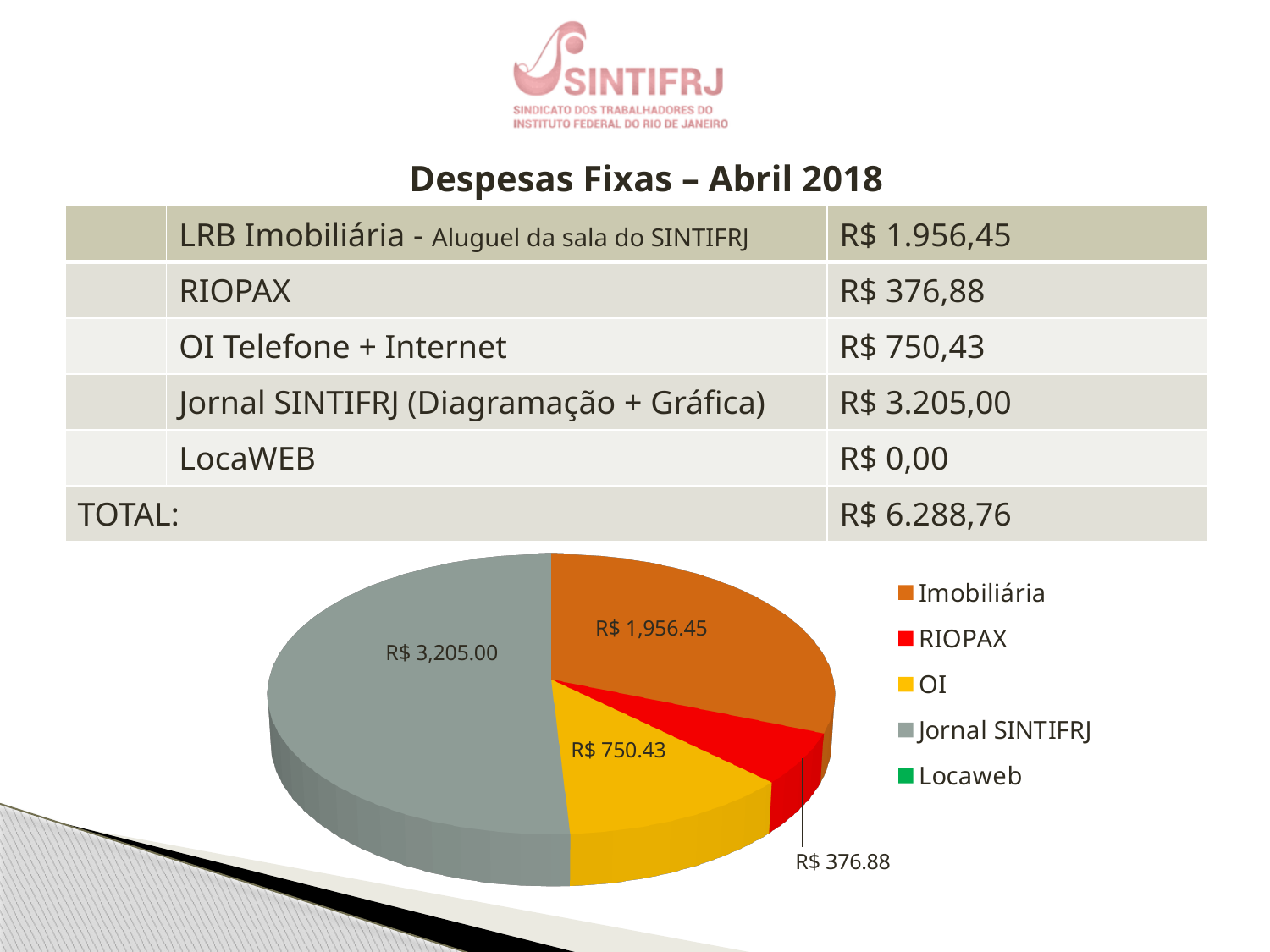
How many entries does the pie chart's legend list? 5 What is the difference between the Jornal SINTIFRJ slice and the Imobiliária slice in the pie chart? R$ 1,248.55 In the pie chart, what is the value of the Jornal SINTIFRJ slice? R$ 3,205.00 What type of chart is shown on the slide? pie chart What is the difference between the OI slice and the RIOPAX slice in the pie chart? R$ 373.55 In the pie chart, what is the value of the RIOPAX slice? R$ 376.88 Which category has the largest slice in the pie chart? Jornal SINTIFRJ In the pie chart, what is the value of the OI slice? R$ 750.43 What colour is the Jornal SINTIFRJ slice in the pie chart? grey Among the slices with printed values, which category has the smallest value in the pie chart? RIOPAX In the pie chart, what is the value of the Imobiliária slice? R$ 1,956.45 In the pie chart, which is larger: the Imobiliária slice or the OI slice? Imobiliária